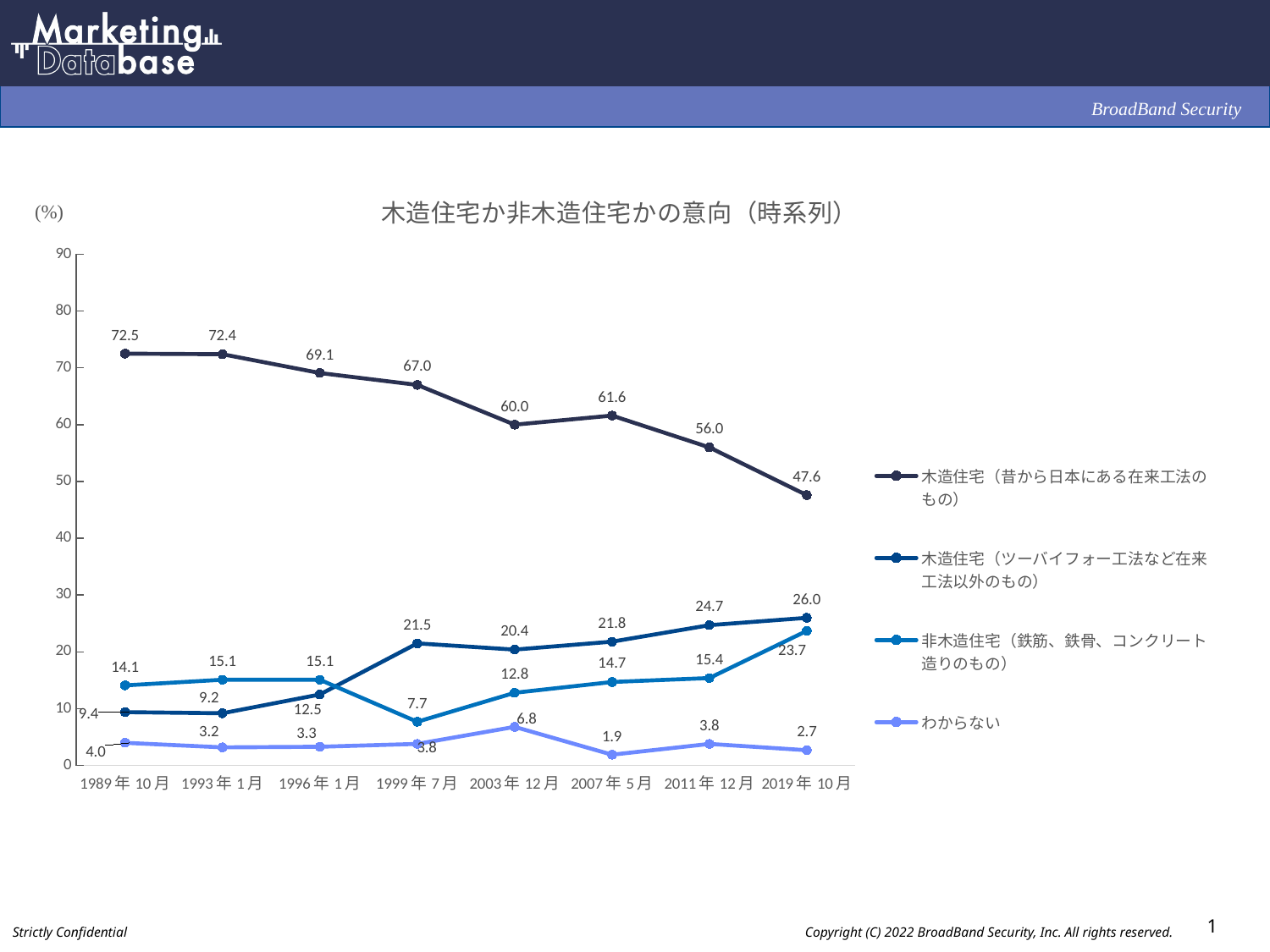
What type of chart is shown on the slide? line chart At which time point is the value for わからない lowest? 2007年5月 Does the value for 木造住宅（ツーバイフォー工法など在来工法以外のもの） generally rise or fall from 1989年10月 to 2019年10月? rise What is the difference between the 1989年10月 and 2019年10月 values for 木造住宅（昔から日本にある在来工法のもの）? 24.9 How many series does the legend list? 4 What is the value for 非木造住宅（鉄筋、鉄骨、コンクリート造りのもの） in 1999年7月? 7.7 What is the value for 木造住宅（昔から日本にある在来工法のもの） in 2019年10月? 47.6 How many time points are plotted along the x axis? 8 In 2019年10月, which is larger: 木造住宅（ツーバイフォー工法など在来工法以外のもの） or 非木造住宅（鉄筋、鉄骨、コンクリート造りのもの）? 木造住宅（ツーバイフォー工法など在来工法以外のもの） What is the value for わからない in 2003年12月? 6.8 What is the title of the chart? 木造住宅か非木造住宅かの意向（時系列） At which time point is the value for 木造住宅（昔から日本にある在来工法のもの） highest? 1989年10月